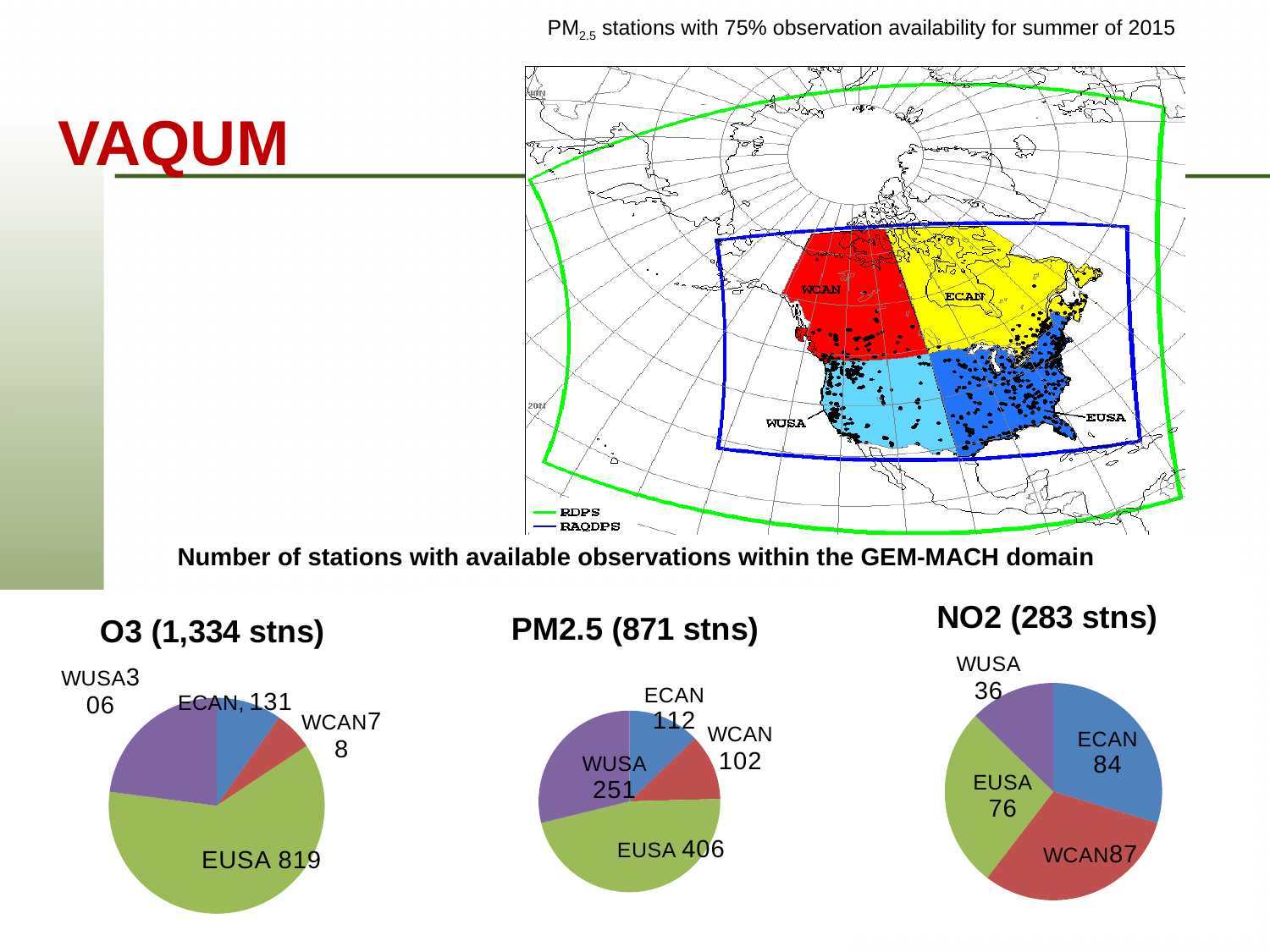
In the O3 (1,334 stns) pie chart, what share of the total stations does EUSA represent, to the nearest percent? 61% What kind of chart is used for NO2 (283 stns)? Pie chart In the NO2 (283 stns) pie chart, what is the difference between the WCAN and EUSA station counts? 11 In the O3 (1,334 stns) pie chart, which region has the largest slice? EUSA How many pie charts are shown on the slide? 3 In the NO2 (283 stns) pie chart, how many stations does ECAN have? 84 In the PM2.5 (871 stns) pie chart, how many stations does WUSA have? 251 In the NO2 (283 stns) pie chart, which region has the smallest slice? WUSA In the O3 (1,334 stns) pie chart, how many stations does EUSA have? 819 In the O3 (1,334 stns) pie chart, which has more stations, ECAN or WCAN? ECAN How many slices does the PM2.5 (871 stns) pie chart have? 4 In the PM2.5 (871 stns) pie chart, what is the difference between the EUSA and WUSA station counts? 155